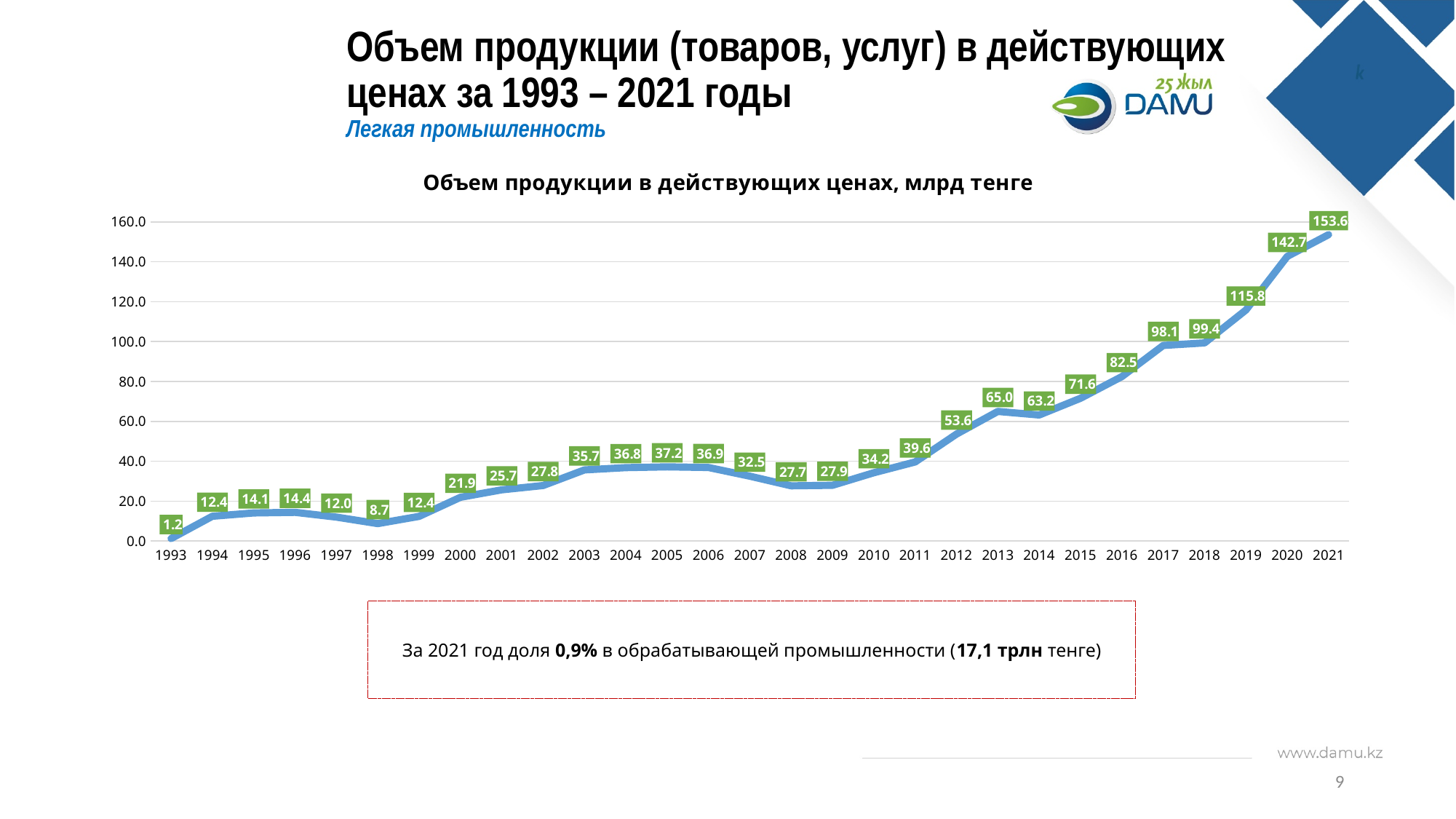
What is the difference between the values for 2013 and 2014? 1.8 Which year has the lowest value in the chart? 1993 What is the difference between the values for 2021 and 2020? 10.9 Which year has the highest value in the chart? 2021 What is the title of the chart? Объем продукции в действующих ценах, млрд тенге What kind of chart is shown on the slide? line chart What is the value for 1998 in the chart? 8.7 How many years are plotted in the chart? 29 Is the value for 2019 greater or less than 100.0? greater Which is larger, the value for 2005 or the value for 2007? 2005 What is the value for 2008 in the chart? 27.7 What is the value for 2021 in the chart? 153.6